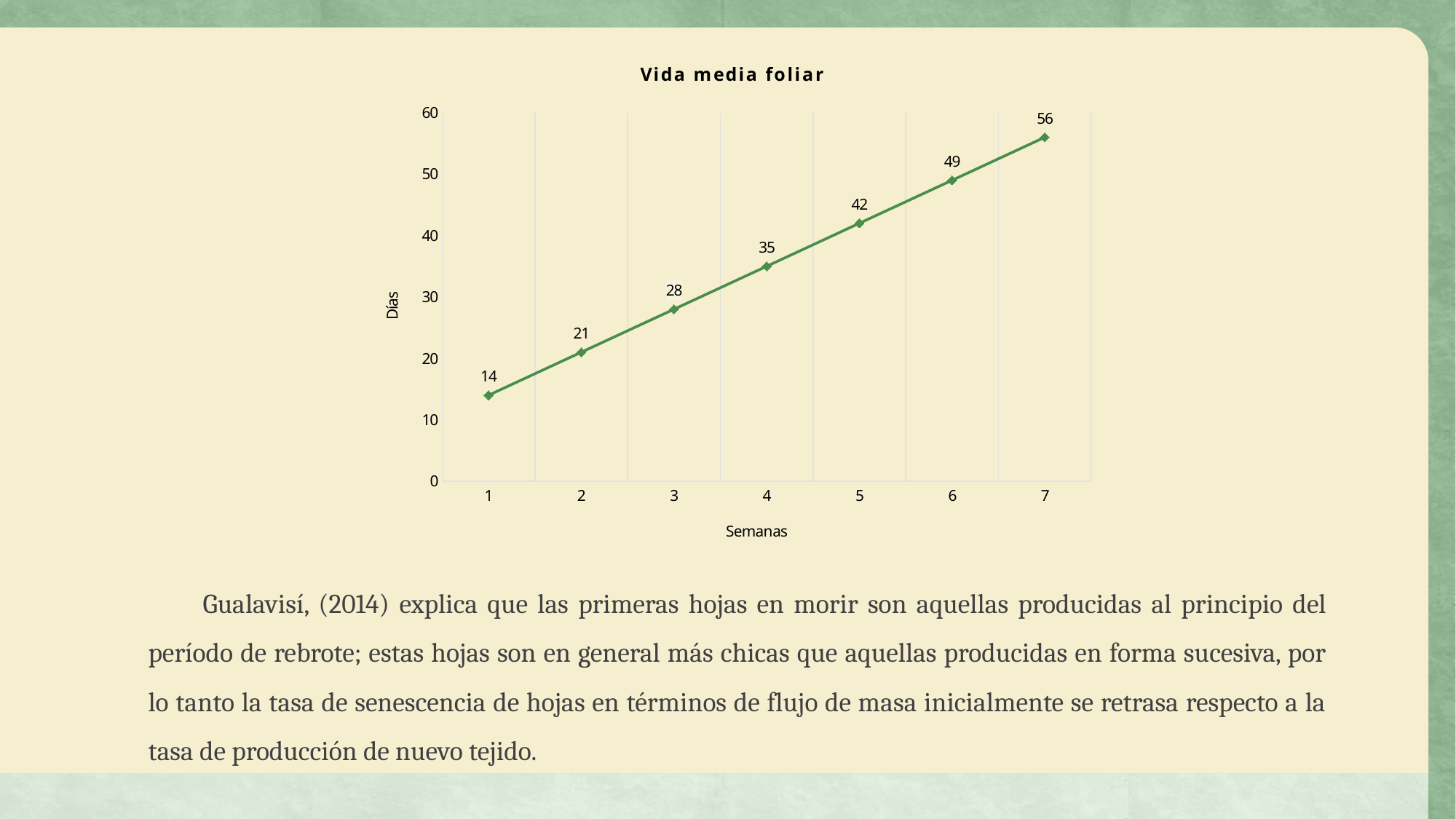
What is the value for week 6 in the 'Vida media foliar' chart? 49 What kind of chart is 'Vida media foliar'? line chart Which week has the highest value in the 'Vida media foliar' chart? 7 What is the difference between the values for week 7 and week 1 in the 'Vida media foliar' chart? 42 What is the value for week 3 in the 'Vida media foliar' chart? 28 Which is larger in the 'Vida media foliar' chart, the value for week 2 or the value for week 5? week 5 What is the label of the vertical axis in the 'Vida media foliar' chart? Días Which week has the lowest value in the 'Vida media foliar' chart? 1 Do the values in the 'Vida media foliar' chart rise or fall as the weeks increase? rise What is the difference between the values for week 5 and week 4 in the 'Vida media foliar' chart? 7 How many data points are plotted in the 'Vida media foliar' chart? 7 Is the value for week 4 in the 'Vida media foliar' chart greater or less than 30? greater